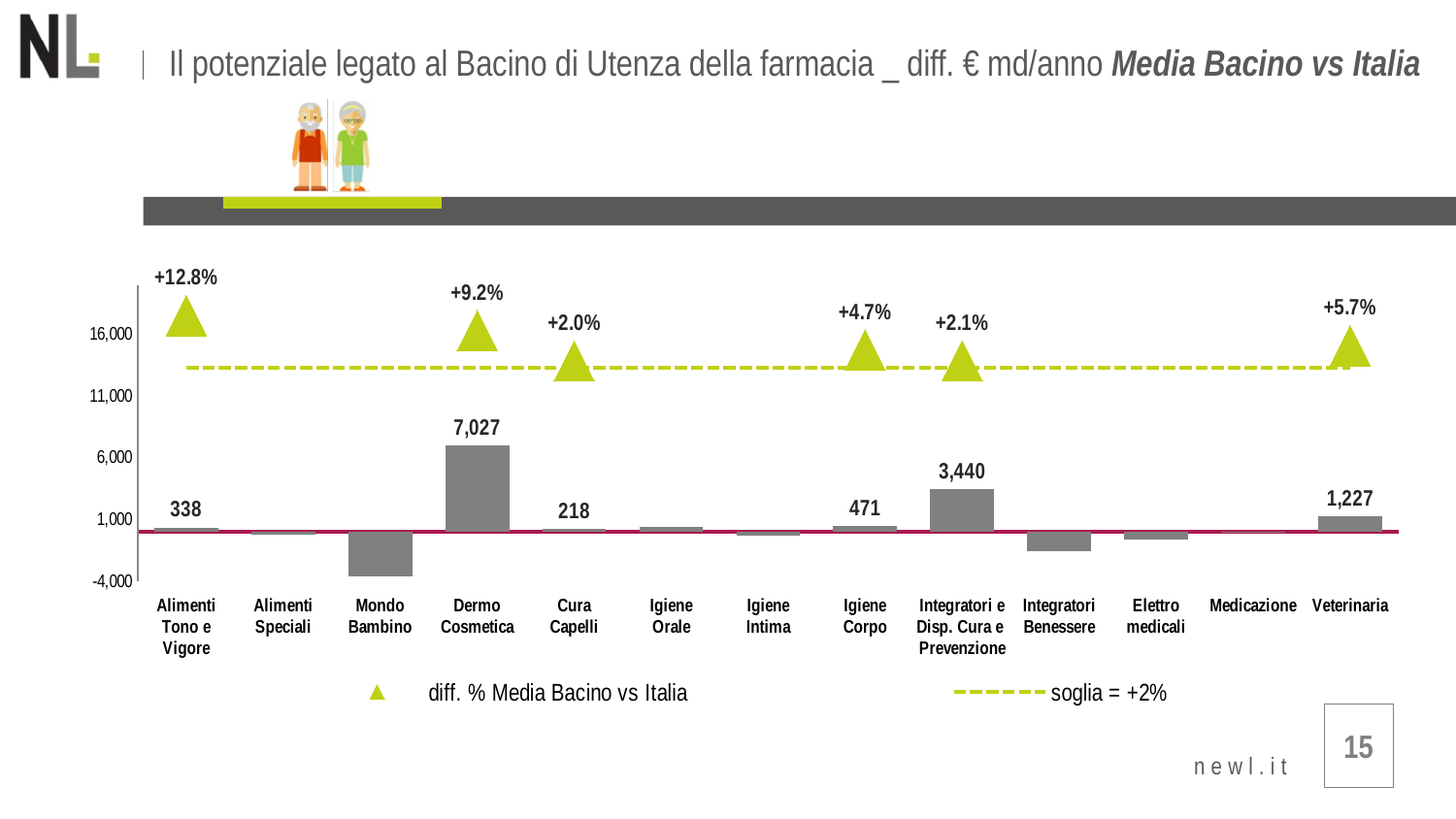
Which is larger, the value for Igiene Corpo or the value for Cura Capelli? Igiene Corpo What is the diff. % Media Bacino vs Italia shown for Alimenti Tono e Vigore? +12.8% What is the diff. % Media Bacino vs Italia shown for Veterinaria? +5.7% What is the difference between the values for Veterinaria and Igiene Corpo? 756 How many categories are shown on the x axis? 13 Is the value for Mondo Bambino greater or less than 1,000? less What threshold (soglia) value does the dashed line in the legend represent? +2% Which category has the lowest bar value? Mondo Bambino Which category has the highest bar value? Dermo Cosmetica What is the difference between the values for Dermo Cosmetica and Integratori e Disp. Cura e Prevenzione? 3,587 What is the value for Integratori e Disp. Cura e Prevenzione? 3,440 What is the value for Dermo Cosmetica? 7,027